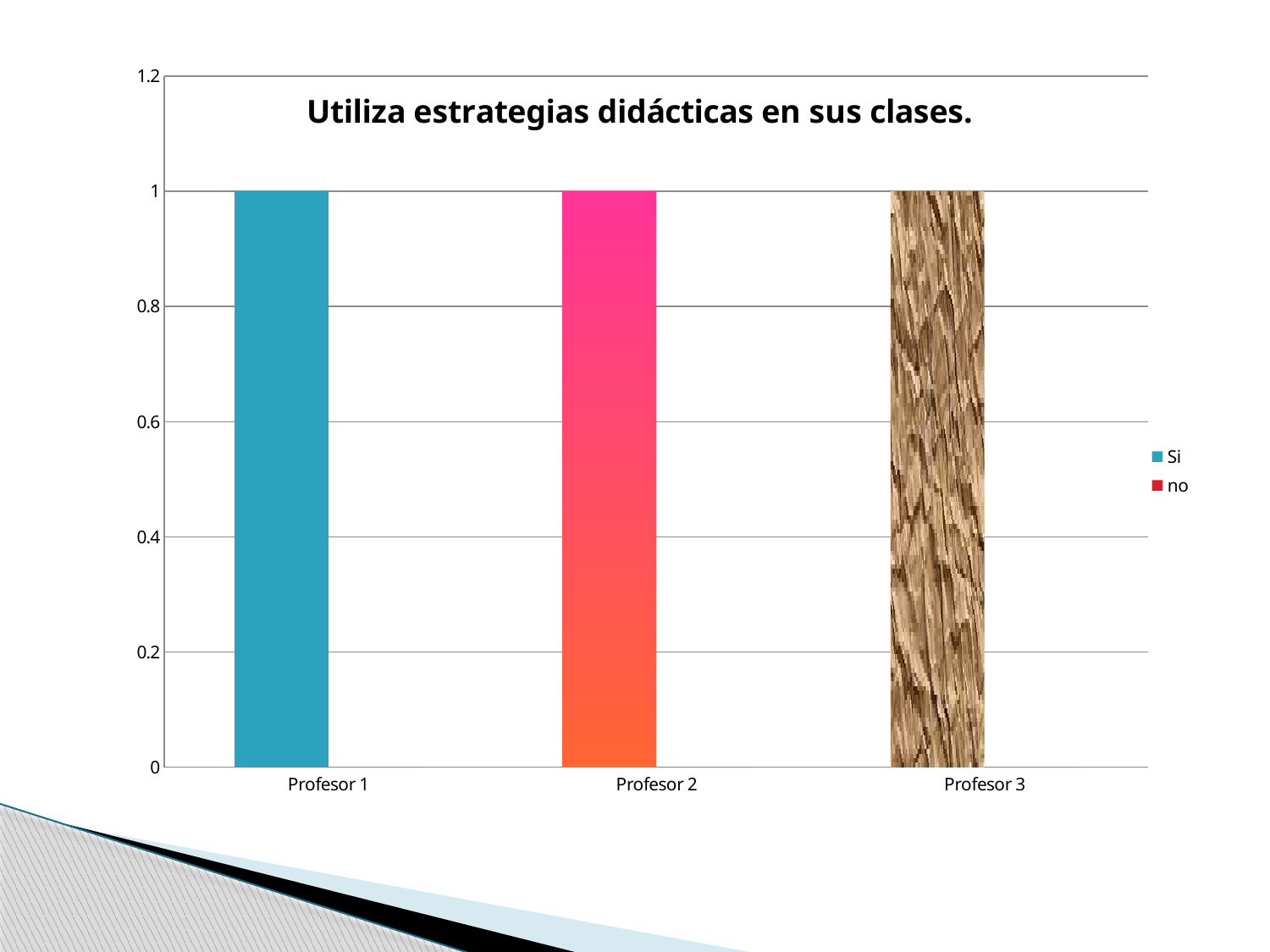
What is the value of the Si bar for Profesor 3? 1 What is the highest value shown on the y axis? 1.2 Is the value for Profesor 1 greater or less than 0.8? greater What kind of chart is shown on the slide? bar chart What is the value of the Si bar for Profesor 2? 1 How many categories are shown on the x axis of the chart? 3 What is the title of the chart? Utiliza estrategias didácticas en sus clases. What is the value of the Si bar for Profesor 1? 1 Is the value for Profesor 3 greater or less than 1.2? less What are the two entries listed in the legend? Si and no How many series does the legend list? 2